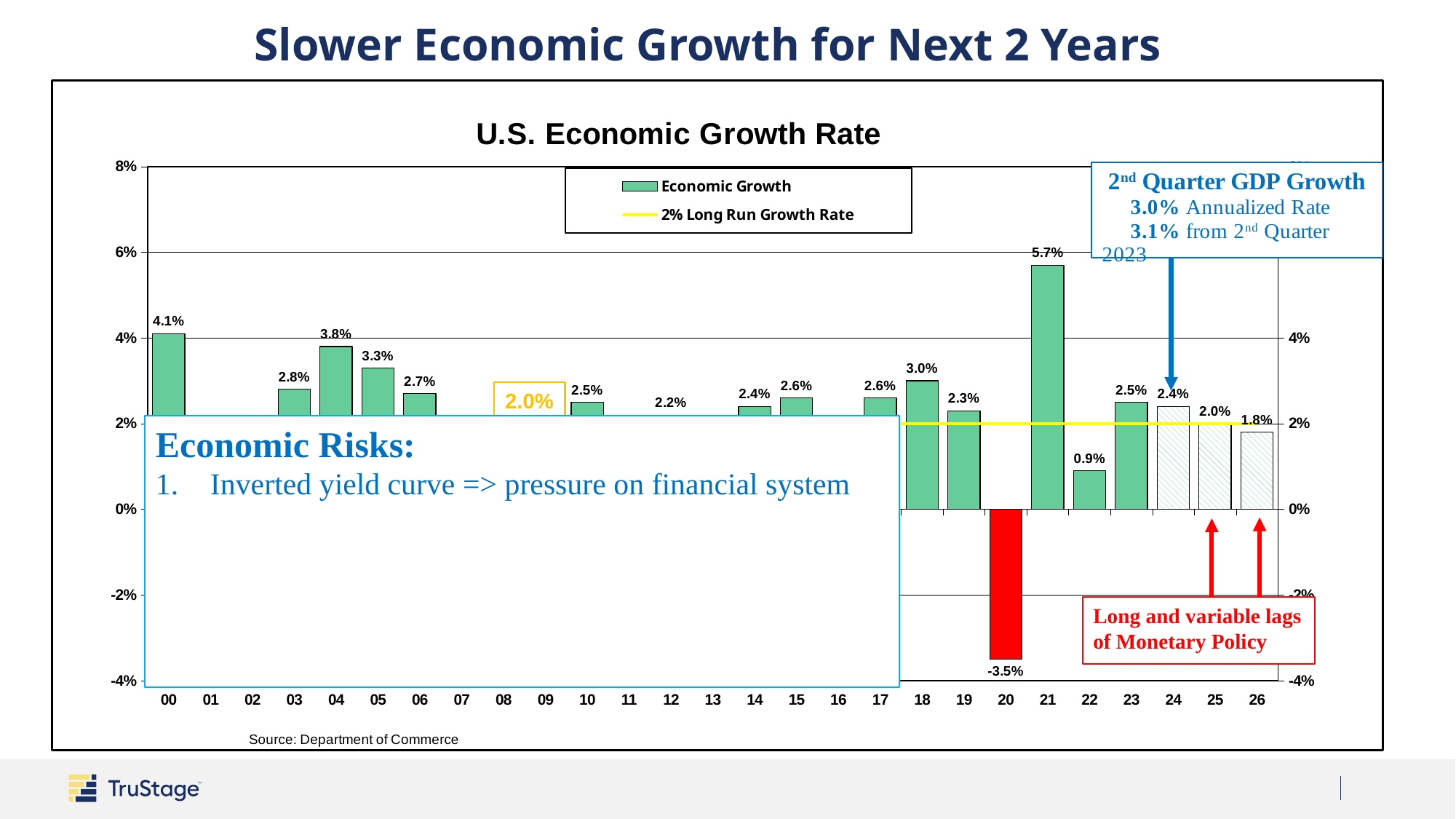
Is the economic growth rate for 22 greater or less than 2%? less What is the economic growth rate for 21? 5.7% How many series does the legend list? 2 What is the title of the chart? U.S. Economic Growth Rate What type of chart is used to show Economic Growth? bar chart Which year has the lowest economic growth rate? 20 What is the economic growth rate for 26? 1.8% What is the difference between the economic growth rate for 21 and for 22? 4.8% Which year has a higher economic growth rate, 04 or 05? 04 What is the economic growth rate for 00? 4.1% What is the economic growth rate for 20? -3.5% Which year has the highest economic growth rate? 21